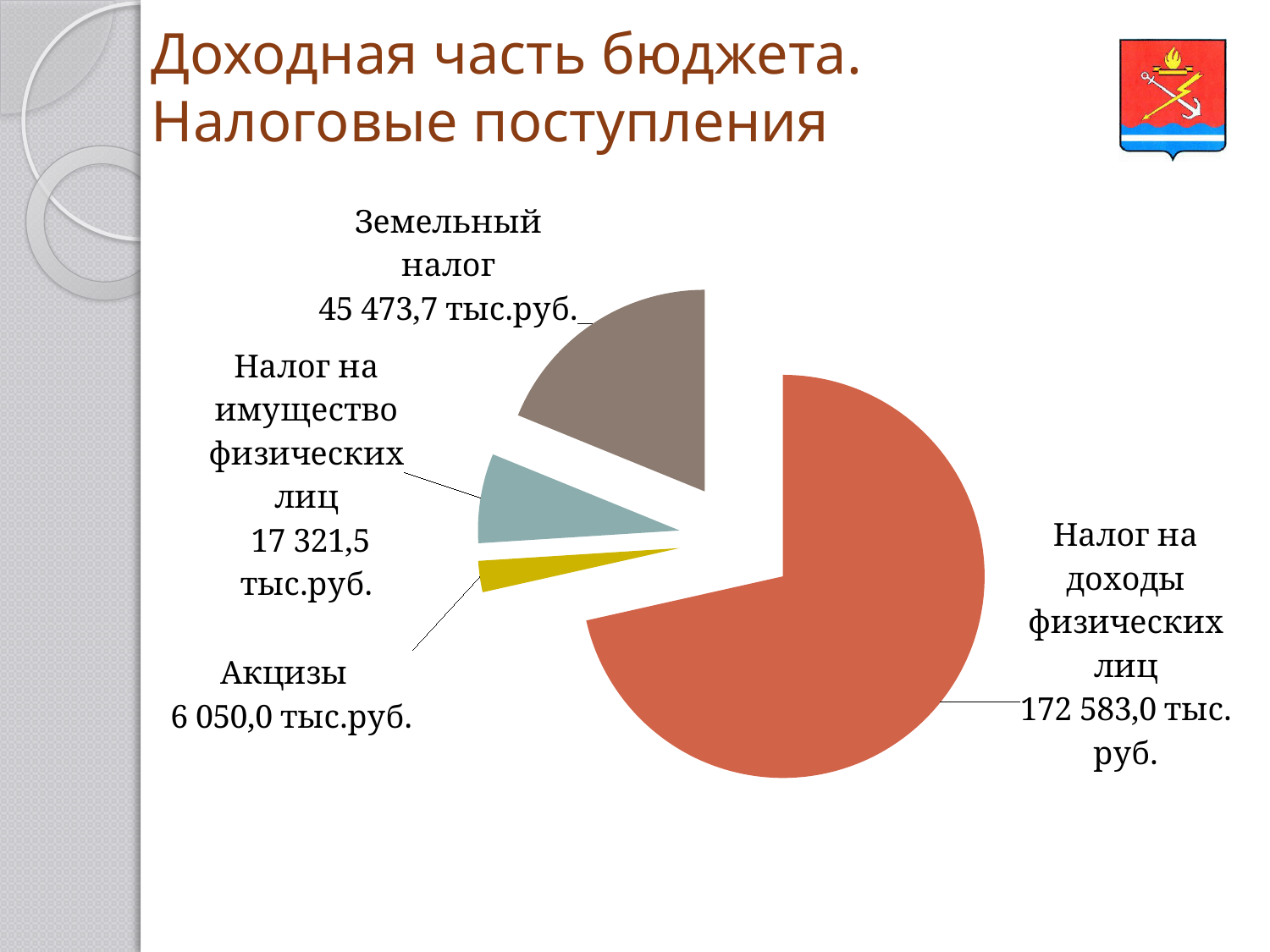
What is the difference between Налог на имущество физических лиц and Акцизы? 11 271,5 тыс. руб. What is the value shown for Налог на имущество физических лиц? 17 321,5 тыс.руб. What is the value shown for Налог на доходы физических лиц? 172 583,0 тыс. руб. How many slices does the pie chart have? 4 What is the title of the slide containing the chart? Доходная часть бюджета. Налоговые поступления What is the difference between Налог на доходы физических лиц and Земельный налог? 127 109,3 тыс. руб. What is the value shown for Земельный налог? 45 473,7 тыс.руб. Which category has the largest slice of the pie? Налог на доходы физических лиц What is the value shown for Акцизы? 6 050,0 тыс.руб. What type of chart is shown on the slide? Pie chart Which category has the smallest slice of the pie? Акцизы Which is larger: Земельный налог or Налог на имущество физических лиц? Земельный налог